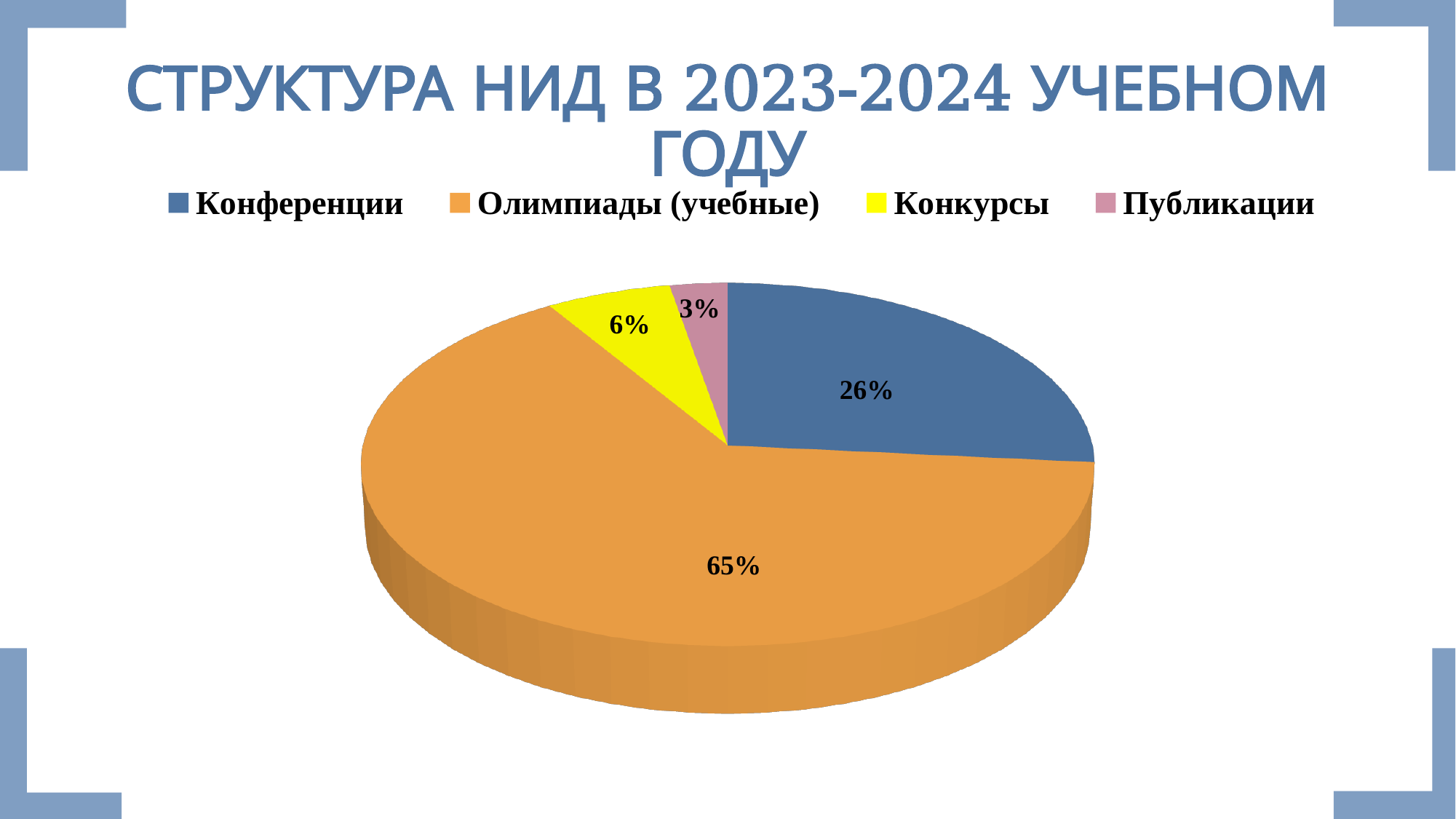
Which category has the largest slice of the pie? Олимпиады (учебные) What kind of chart is shown on the slide? Pie chart Which category has the smallest slice of the pie? Публикации What is the difference between the shares of Олимпиады (учебные) and Конференции? 39% What is the value shown for Конференции? 26% What colour is the slice for Конкурсы? Yellow What is the difference between the shares of Конкурсы and Публикации? 3% What is the value shown for Конкурсы? 6% What share of the pie does Олимпиады (учебные) take? 65% How many categories are shown in the pie chart? 4 What is the value shown for Публикации? 3% Which is larger, the share of Конференции or the share of Конкурсы? Конференции